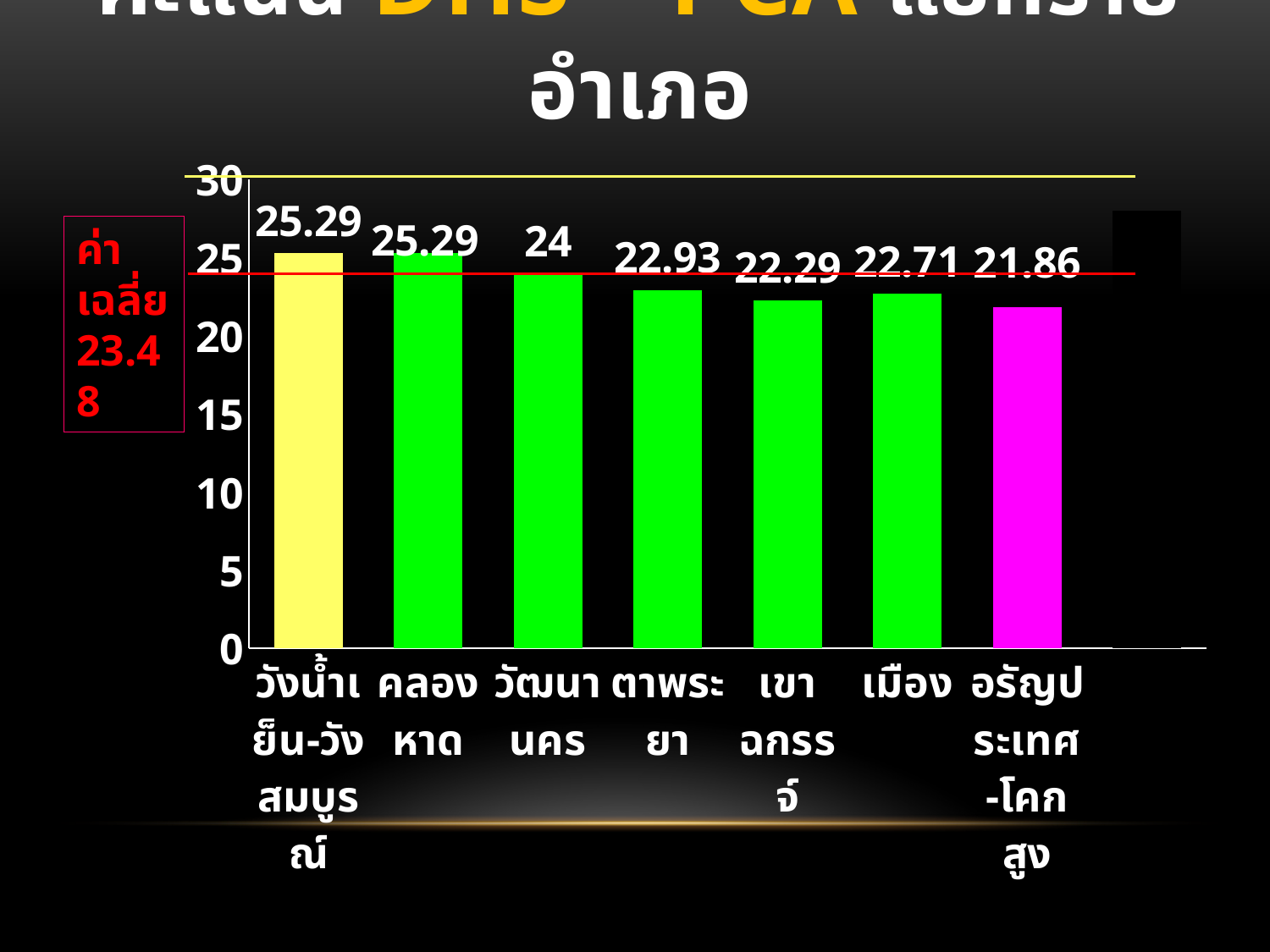
Which district has the lowest value? อรัญประเทศ-โคกสูง What is the value for วัฒนานคร? 24 What is the difference between the values for วัฒนานคร and ตาพระยา? 1.07 Which is larger, the value for เมือง or the value for เขาฉกรรจ์? เมือง What is the value for เมือง? 22.71 Is the value for คลองหาด greater or less than 25? greater What is the value for อรัญประเทศ-โคกสูง? 21.86 What kind of chart is shown on the slide? bar chart What is the value for เขาฉกรรจ์? 22.29 What is the value for ตาพระยา? 22.93 What average value (ค่าเฉลี่ย) is shown in the red label on the chart? 23.48 How many districts are shown on the chart? 7